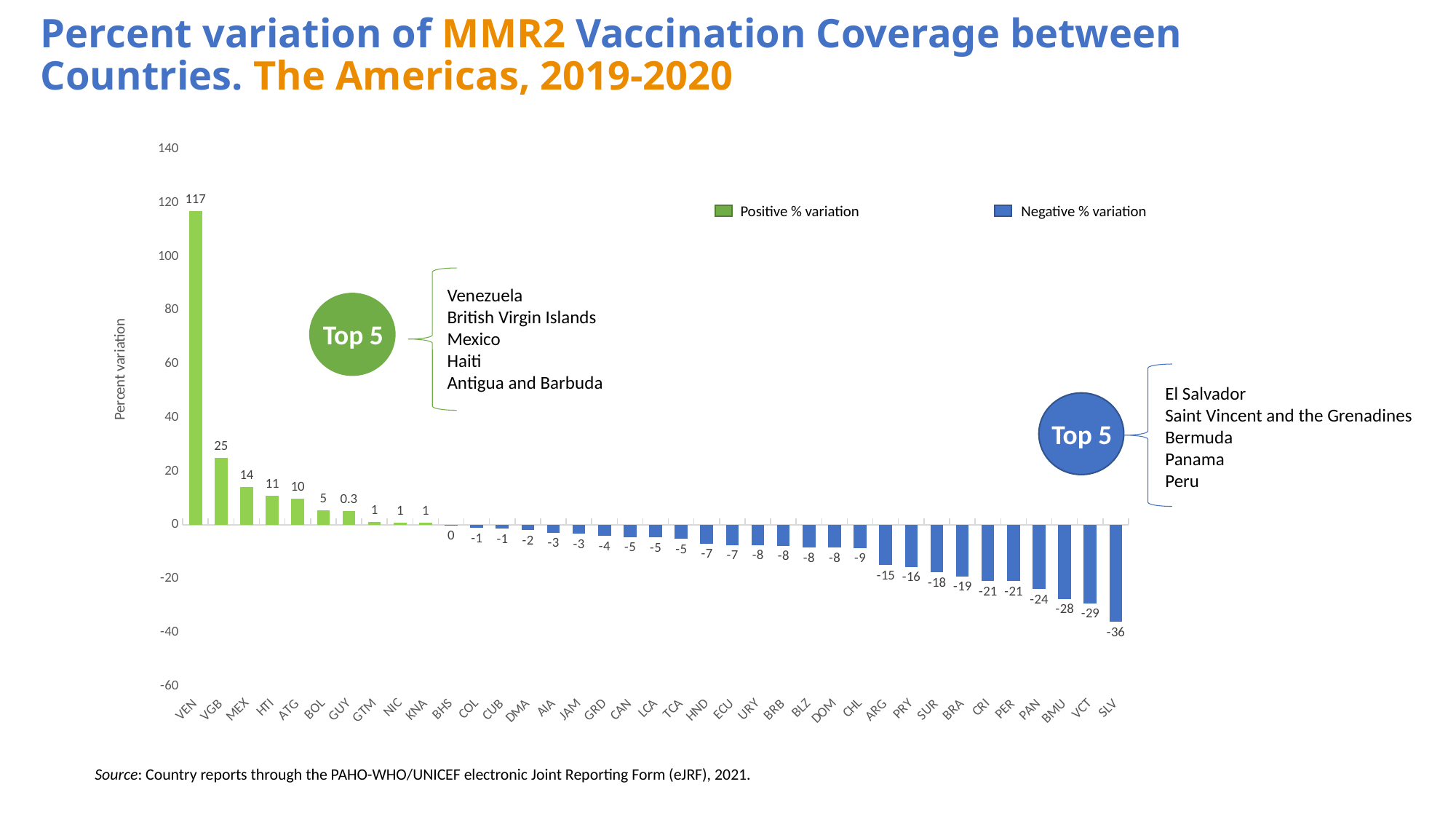
How many countries are shown on the x axis? 37 Which country has the highest percent variation? VEN Which country has the lowest percent variation? SLV What is the percent variation for MEX? 14 What is the difference between the percent variation for VEN and VGB? 92 Which colour represents negative % variation in the legend? blue Is the value for VEN greater or less than 100? greater What is the percent variation for SLV? -36 What is the percent variation for VEN? 117 Which has a larger percent variation, HTI or ATG? HTI What kind of chart is shown on the slide? bar chart How many series does the legend list? 2